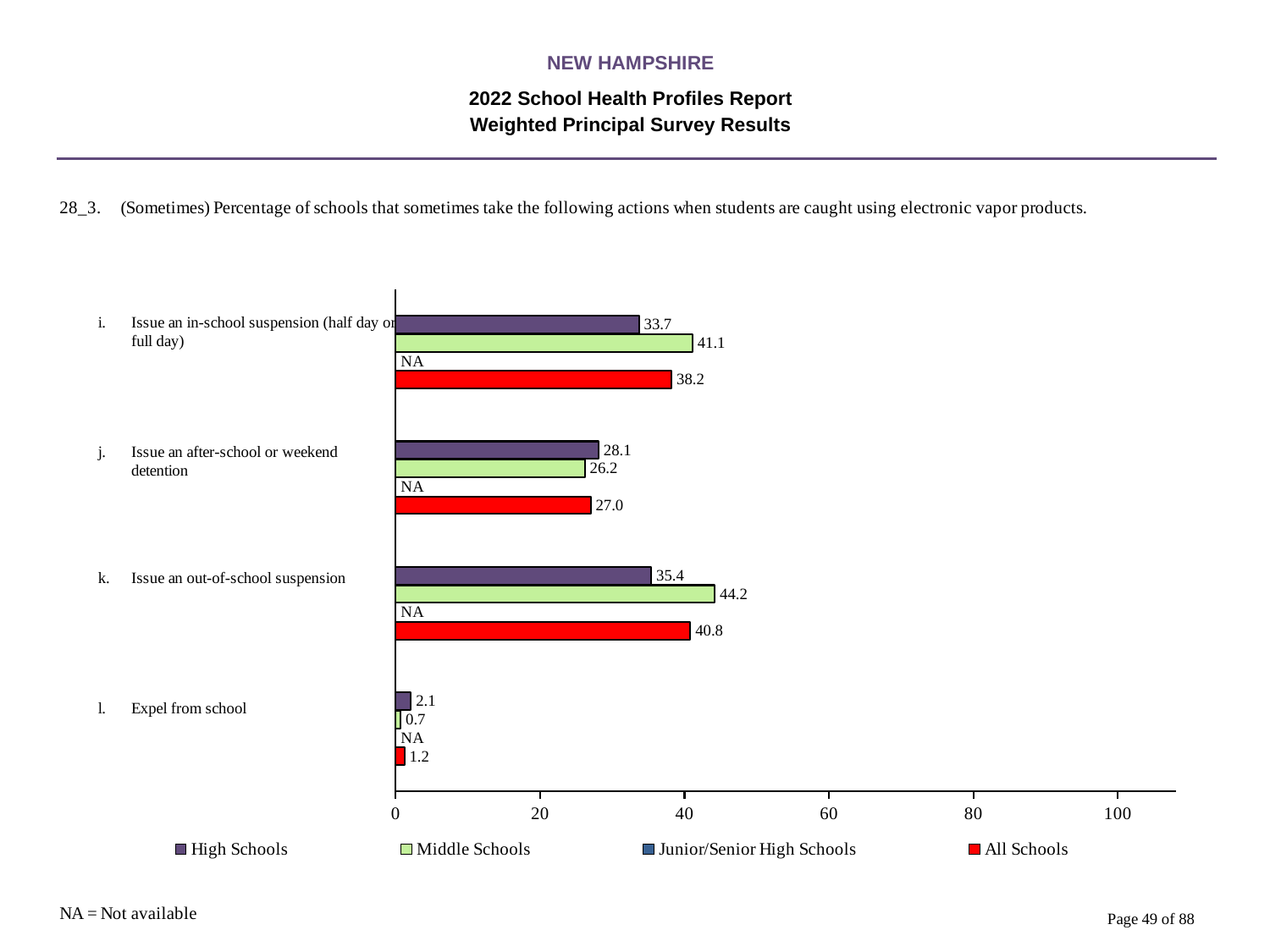
How many actions (categories) are shown on the chart? 4 Which action has the highest All Schools value? Issue an out-of-school suspension Is the Middle Schools value for 'Issue an in-school suspension (half day or full day)' greater or less than 40? greater What is the value for High Schools for 'Issue an after-school or weekend detention'? 28.1 How many series does the legend list? 4 What is the difference between the Middle Schools and High Schools values for 'Issue an out-of-school suspension'? 8.8 For 'Issue an after-school or weekend detention', which is larger: the High Schools value or the Middle Schools value? High Schools What is the value for Junior/Senior High Schools for 'Expel from school'? NA What is the All Schools value for 'Issue an in-school suspension (half day or full day)'? 38.2 What is the value for Middle Schools for 'Issue an out-of-school suspension'? 44.2 What kind of chart is shown on the slide? Bar chart Which action has the lowest Middle Schools value? Expel from school